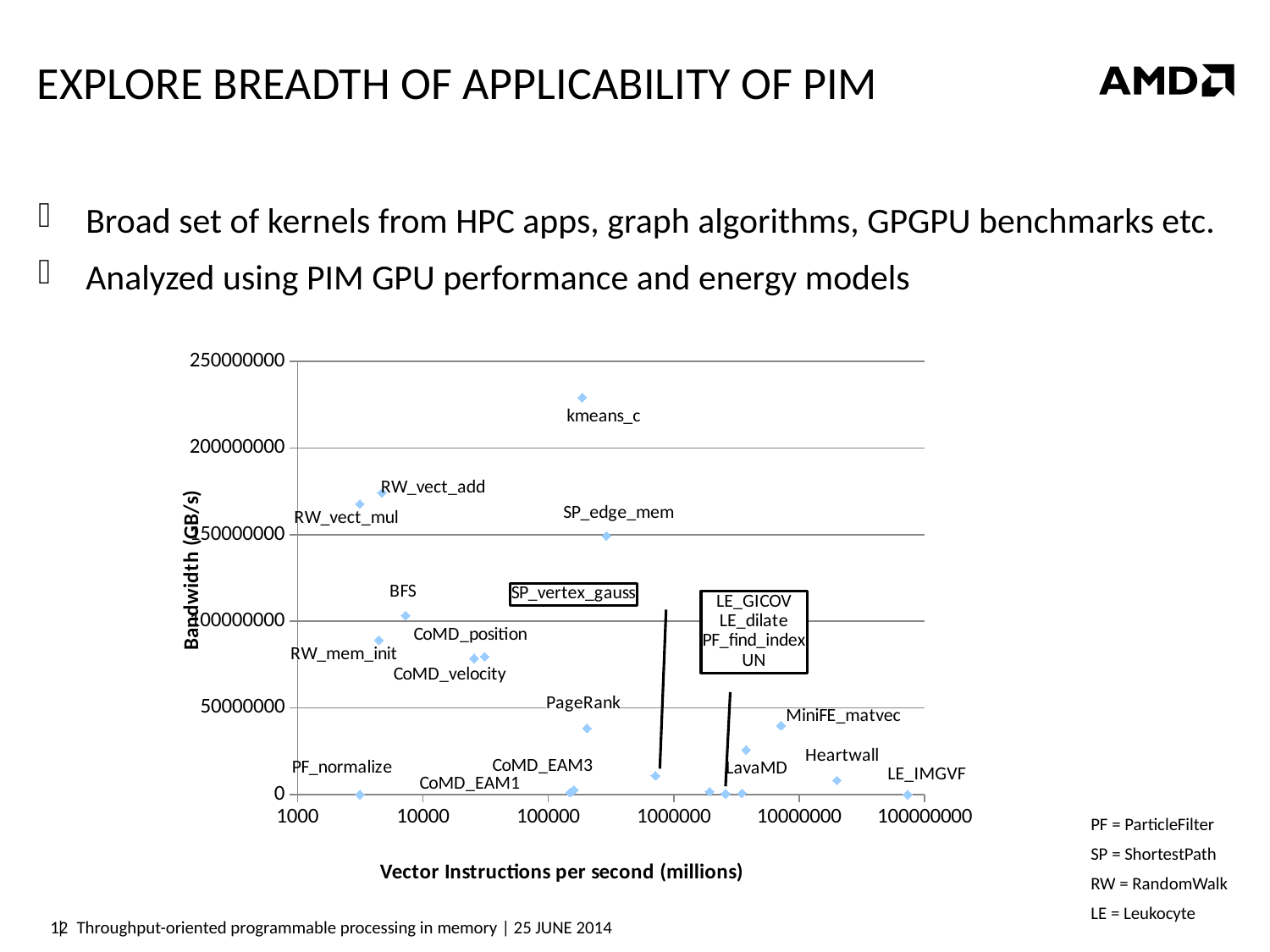
What kind of chart is shown on the slide? scatter chart Is the bandwidth for kmeans_c greater or less than 200000000? greater What is the label of the horizontal axis of the chart? Vector Instructions per second (millions) Which kernel has the highest bandwidth in the chart? kmeans_c Is the bandwidth for RW_vect_add greater or less than 150000000? greater Is the bandwidth for MiniFE_matvec greater or less than 50000000? less What is the label of the vertical axis of the chart? Bandwidth (GB/s) Which has the higher bandwidth, kmeans_c or SP_edge_mem? kmeans_c Which has the higher bandwidth, CoMD_position or PageRank? CoMD_position Which has the higher bandwidth, RW_vect_add or BFS? RW_vect_add